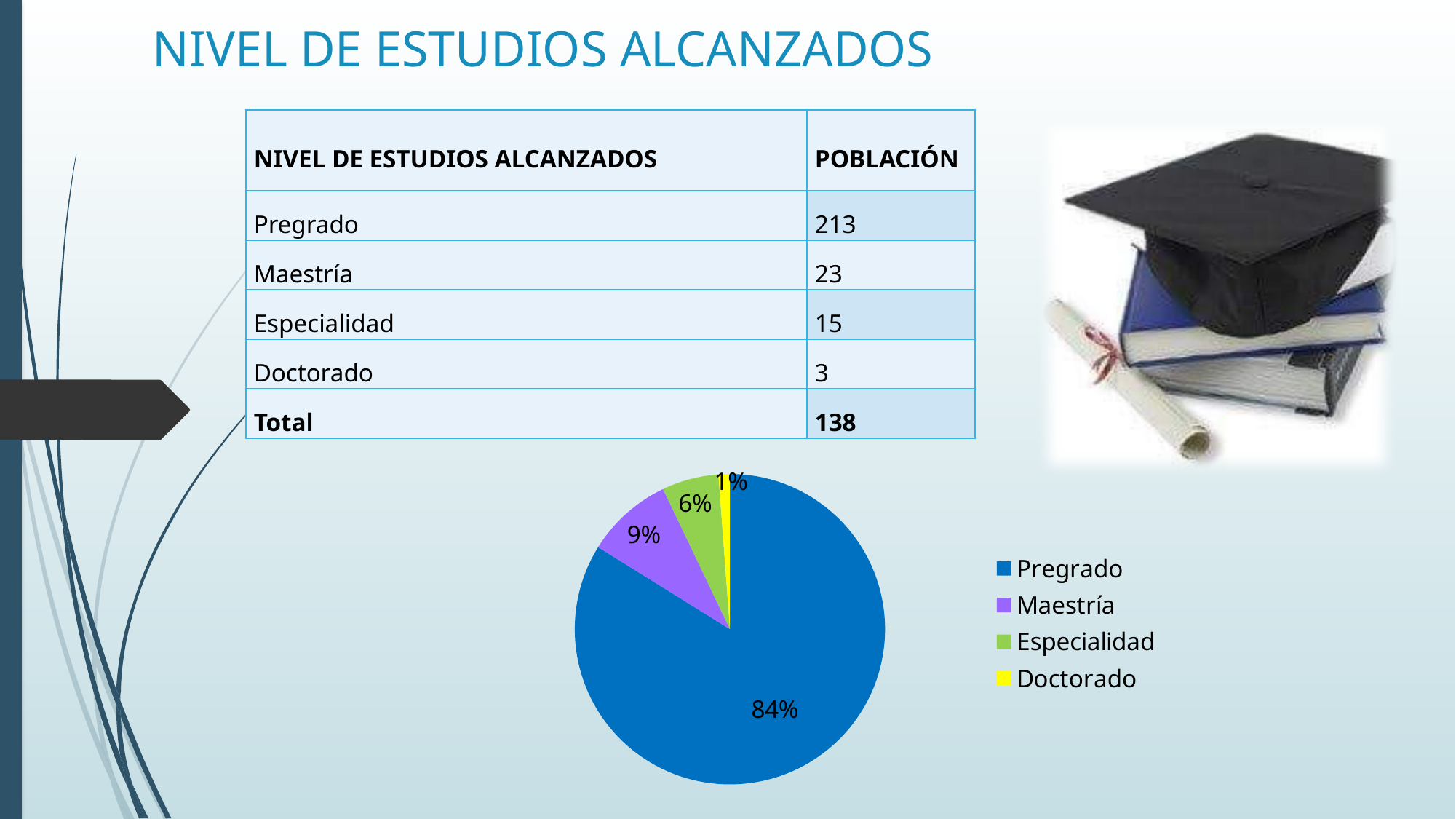
What colour is the Doctorado slice in the pie chart? yellow What kind of chart is shown on the slide? pie chart What share of the pie chart does Doctorado represent? 1% What share of the pie chart does Especialidad represent? 6% Which category has the smallest slice in the pie chart? Doctorado How many categories does the pie chart legend list? 4 What colour is the Pregrado slice in the pie chart? blue What share of the pie chart does Maestría represent? 9% Which category has the largest slice in the pie chart? Pregrado Which slice is larger in the pie chart, Maestría or Especialidad? Maestría What is the difference in percentage points between the Pregrado and Maestría slices? 75%